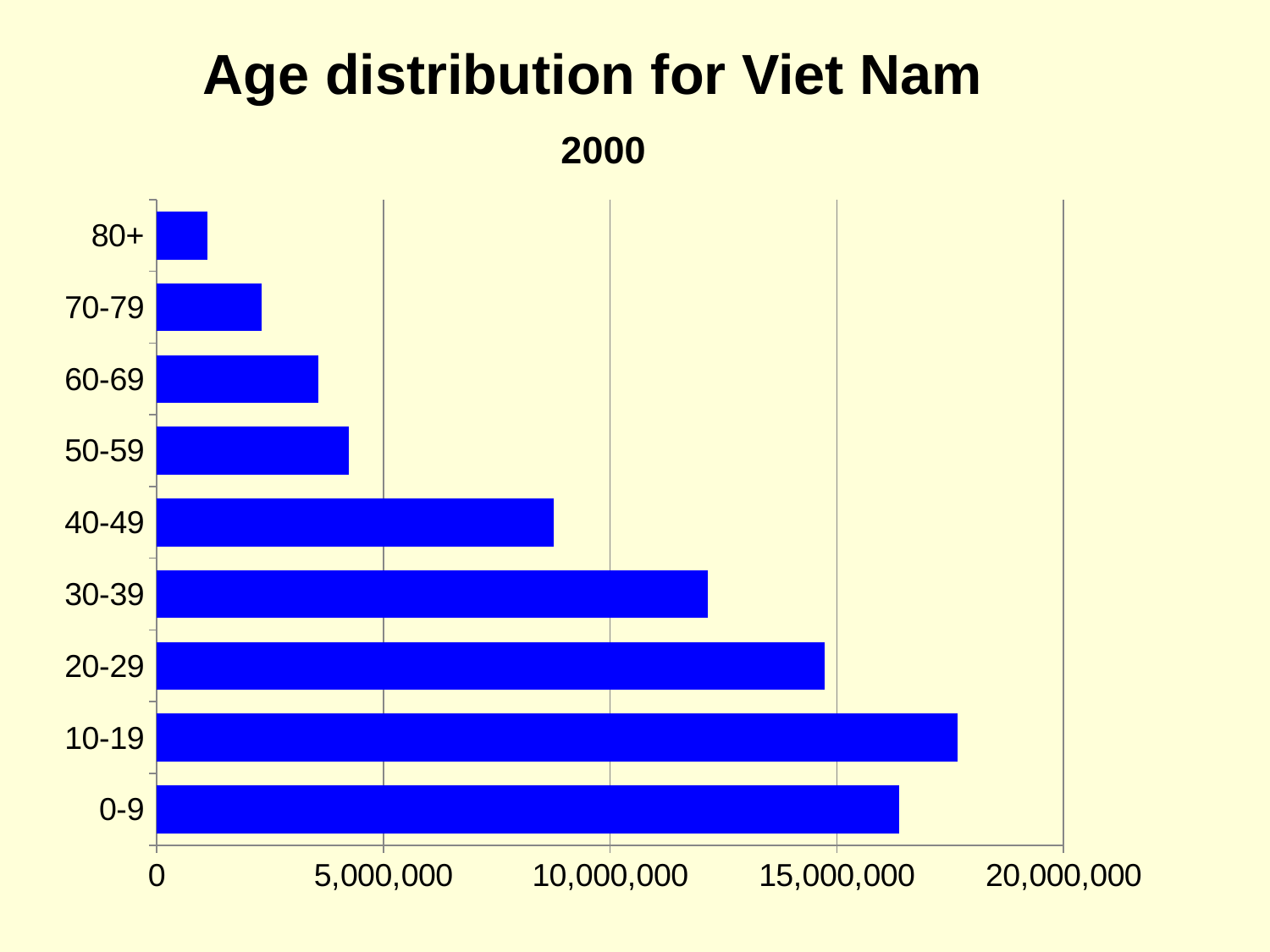
Is the value for the 10-19 age group greater or less than 15,000,000? greater What kind of chart is shown on the slide? bar chart Which age group has the lowest value? 80+ Is the value for the 40-49 age group greater or less than 5,000,000? greater How many age groups are shown in the chart? 9 Is the value for the 50-59 age group greater or less than 5,000,000? less Which is larger, the value for the 20-29 age group or the 30-39 age group? 20-29 Which age group has the highest value? 10-19 Which is larger, the value for the 10-19 age group or the 0-9 age group? 10-19 Which year does the chart show data for? 2000 What is the title of the chart? 2000